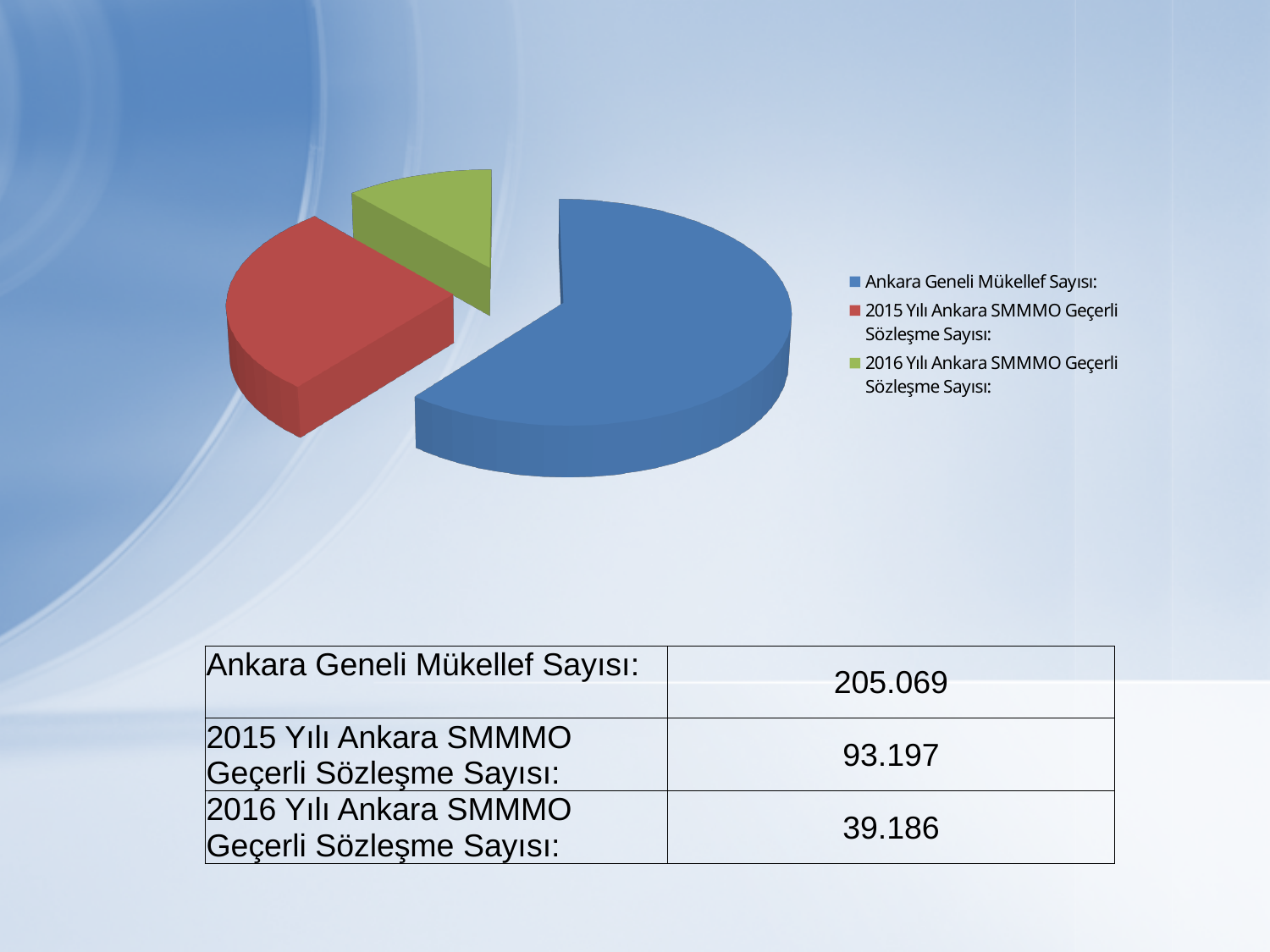
What is the value for 2015 Yılı Ankara SMMMO Geçerli Sözleşme Sayısı? 93.197 Which is larger: the 2015 Yılı Ankara SMMMO Geçerli Sözleşme Sayısı or the 2016 Yılı Ankara SMMMO Geçerli Sözleşme Sayısı? 2015 Yılı Ankara SMMMO Geçerli Sözleşme Sayısı What is the difference between Ankara Geneli Mükellef Sayısı and the 2015 Yılı Ankara SMMMO Geçerli Sözleşme Sayısı? 111.872 What is the difference between the 2015 and 2016 Ankara SMMMO Geçerli Sözleşme Sayısı values? 54.011 What is the value for Ankara Geneli Mükellef Sayısı? 205.069 What kind of chart is shown on the slide? Pie chart Which category has the largest slice of the pie chart? Ankara Geneli Mükellef Sayısı Which category has the smallest slice of the pie chart? 2016 Yılı Ankara SMMMO Geçerli Sözleşme Sayısı How many slices does the pie chart have? 3 What is the value for 2016 Yılı Ankara SMMMO Geçerli Sözleşme Sayısı? 39.186 How many entries does the legend of the pie chart list? 3 What colour is the slice for Ankara Geneli Mükellef Sayısı in the pie chart? Blue